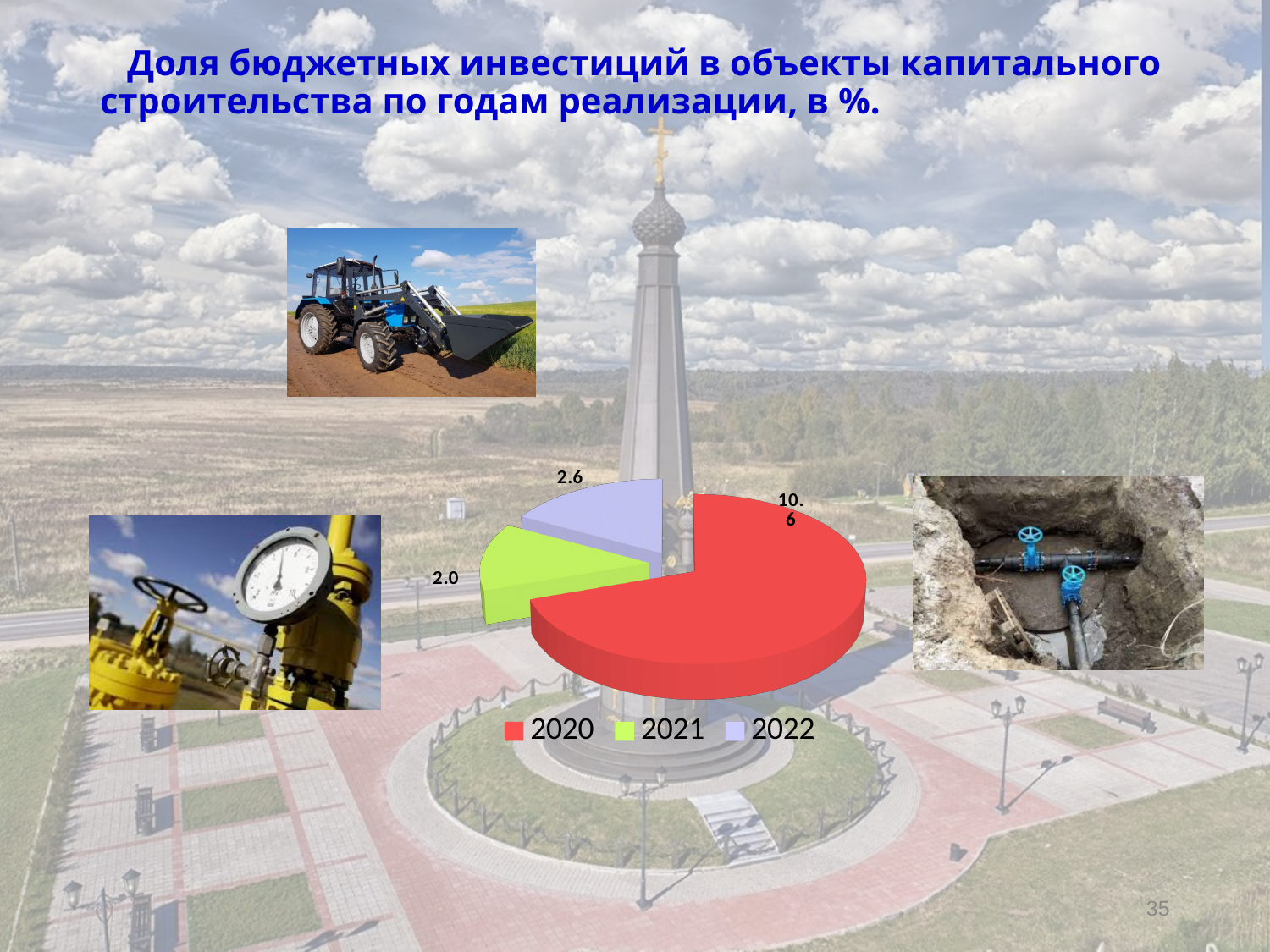
Which is larger, the value for 2021 or the value for 2022? 2022 What kind of chart is shown on the slide? Pie chart How many entries does the legend list? 3 What is the difference between the values for 2020 and 2022? 8.0 How many slices does the pie chart have? 3 What is the value for 2021 in the pie chart? 2.0 What is the value for 2022 in the pie chart? 2.6 What is the difference between the values for 2022 and 2021? 0.6 What is the value for 2020 in the pie chart? 10.6 Which year has the largest slice in the pie chart? 2020 Which year has the smallest slice in the pie chart? 2021 What colour is the slice for 2021 in the pie chart? Green